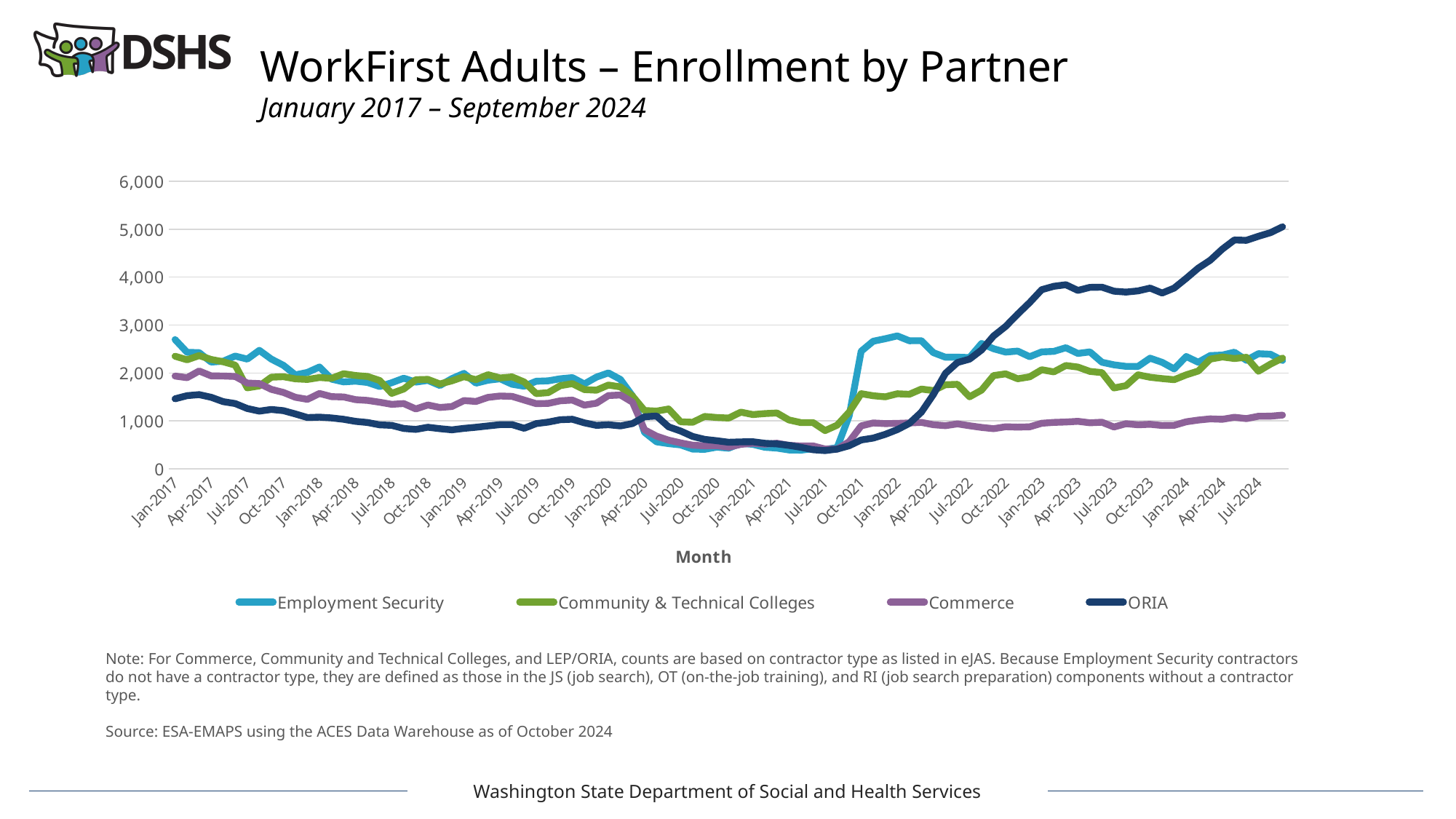
Is the value for ORIA at Jul-2024 greater or less than 4,000? greater Which series has the highest value at the end of the period (Jul-2024 onward)? ORIA What is the title of the chart? WorkFirst Adults – Enrollment by Partner How many series does the legend list? 4 What is the label on the x axis of the chart? Month Is the value for ORIA at Jan-2017 greater or less than 2,000? less Which series has the lowest value at the end of the period (Jul-2024 onward)? Commerce At Jan-2017, which series is larger: Employment Security or ORIA? Employment Security What kind of chart is shown on the slide? line chart Is the value for Employment Security at Jan-2017 greater or less than 2,000? greater Does the ORIA series rise or fall from Jan-2022 to Jul-2024? rise